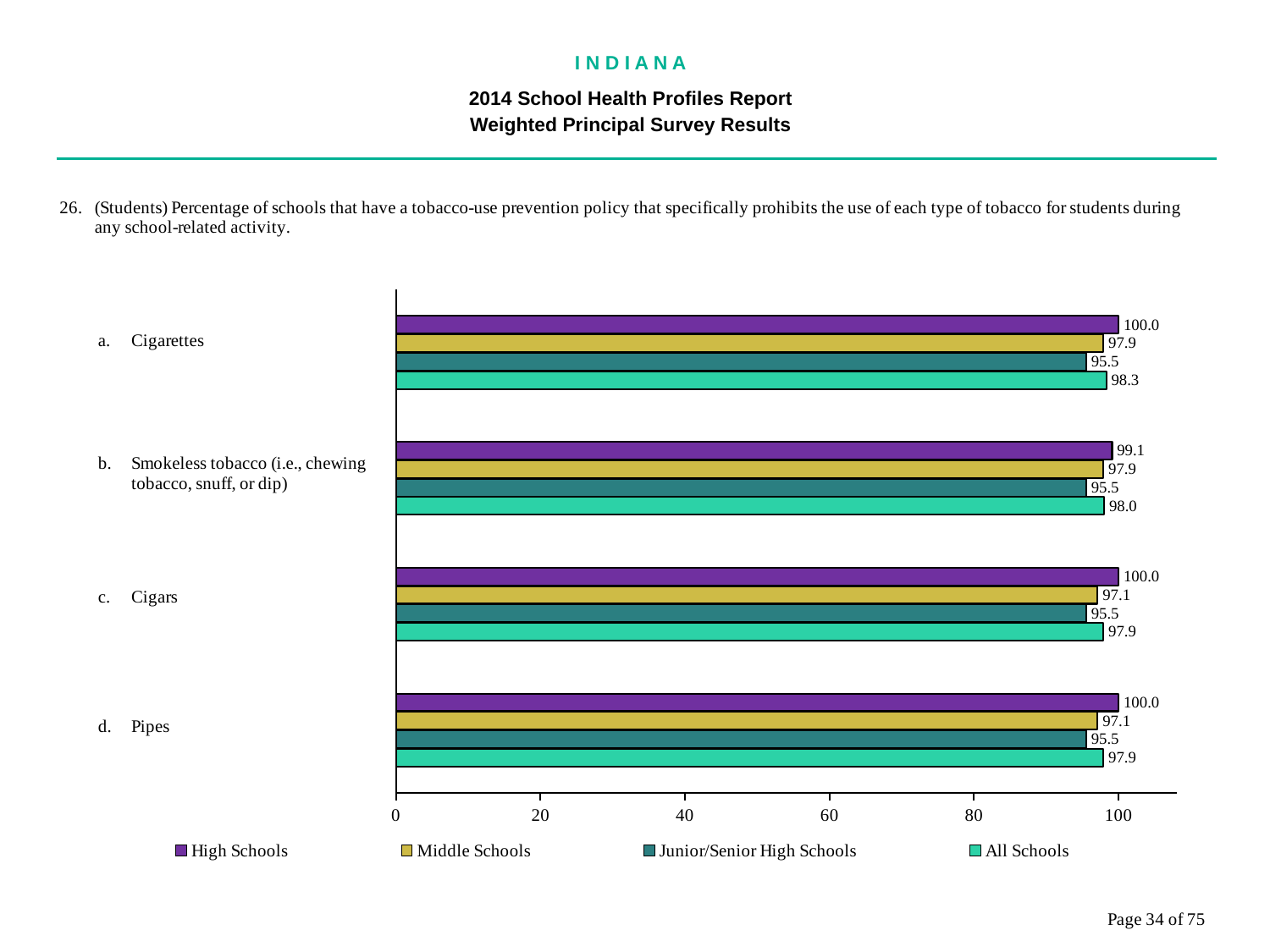
What is the value for Middle Schools for Cigars? 97.1 What is the difference between the High Schools and Middle Schools values for Cigars? 2.9 What kind of chart is shown on the slide? Bar chart How many series does the legend list? 4 Which series has the lowest value for Cigarettes? Junior/Senior High Schools What is the value for Junior/Senior High Schools for Pipes? 95.5 Which is larger for Smokeless tobacco: the High Schools value or the All Schools value? High Schools What is the value for High Schools for Cigarettes? 100.0 Which series has the highest value for Pipes? High Schools How many tobacco categories are shown on the chart? 4 Which legend entry is shown in purple? High Schools What is the value for All Schools for Smokeless tobacco? 98.0